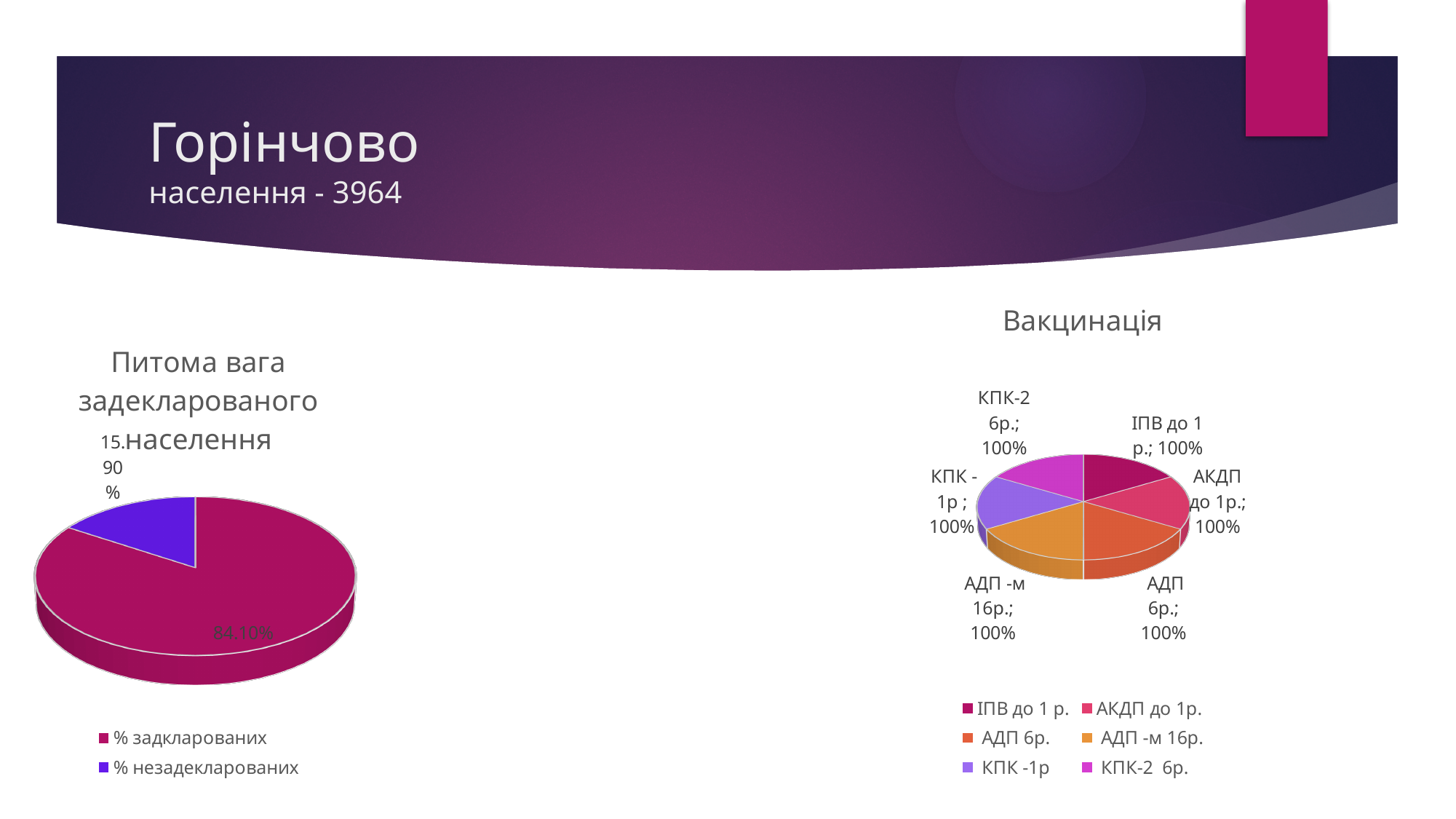
What kind of chart is the "Вакцинація" chart on the right? pie chart In the "Питома вага задекларованого населення" chart, what is the difference between the "% задкларованих" and "% незадекларованих" values? 68.20% How many entries does the legend of the "Питома вага задекларованого населення" chart list? 2 How many slices does the "Вакцинація" chart have? 6 What kind of chart is the "Питома вага задекларованого населення" chart on the left? pie chart How many slices does the "Питома вага задекларованого населення" chart have? 2 In the "Вакцинація" chart, what value is shown for "КПК-2 6р."? 100% In the "Питома вага задекларованого населення" chart, which slice is larger: "% задкларованих" or "% незадекларованих"? % задкларованих What is the title of the pie chart on the right side of the slide? Вакцинація In the "Питома вага задекларованого населення" chart, what is the value for "% незадекларованих"? 15.90% In the "Вакцинація" chart, what value is shown for "АКДП до 1р."? 100% In the "Питома вага задекларованого населення" chart, what is the value for "% задкларованих"? 84.10%